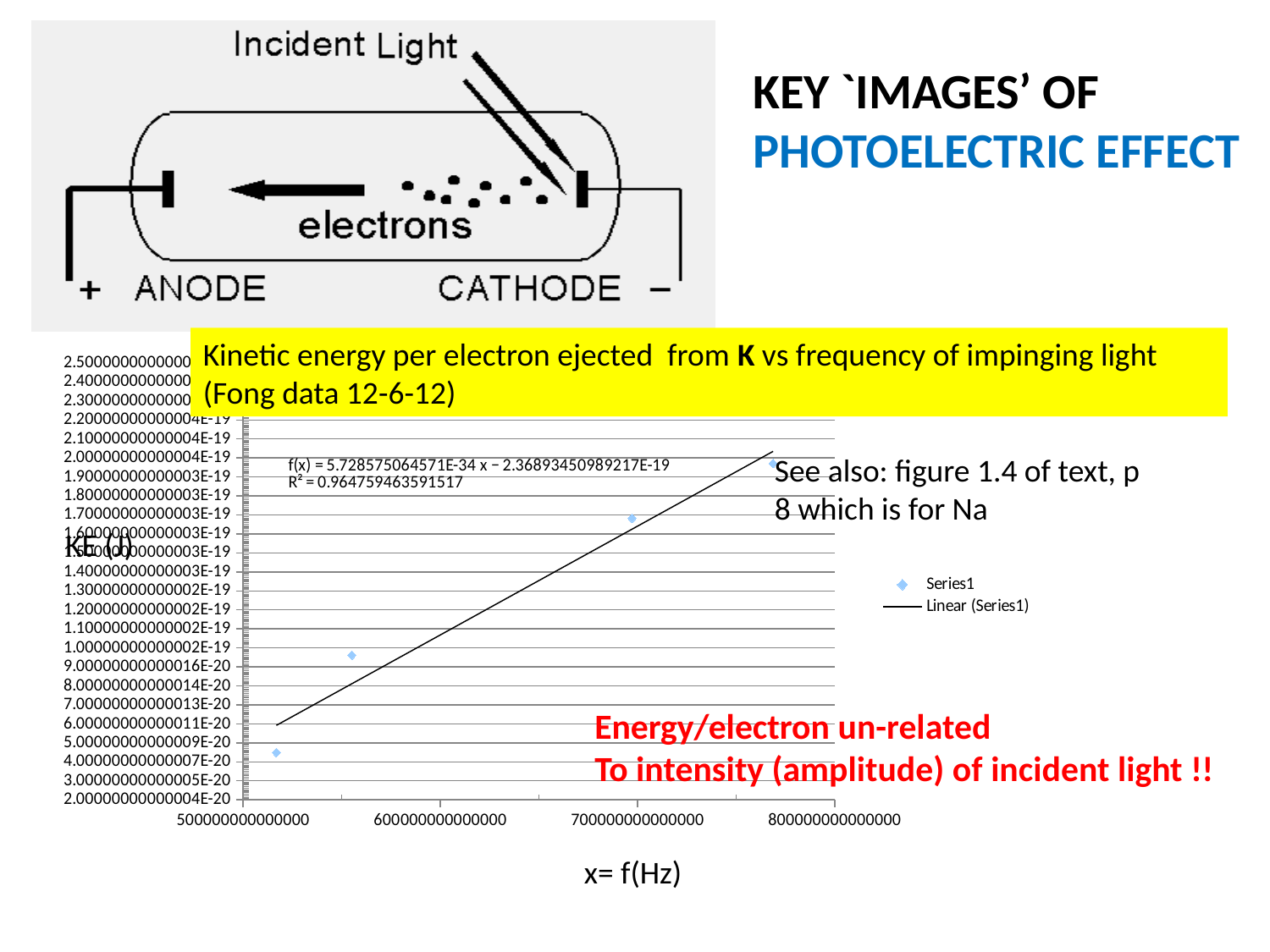
What is the slope of the linear trendline equation printed on the chart? 5.728575064571E-34 What kind of chart is shown on the slide? scatter chart What R² value is printed for the linear trendline on the chart? 0.964759463591517 Is the kinetic energy of the data point just below 600000000000000 Hz greater or less than 1.20000000000002E-19? less Do the plotted kinetic energy values rise or fall as frequency increases along the x axis? rise Is the kinetic energy of the data point at the highest frequency greater or less than 1.80000000000003E-19? greater How many data points are plotted in the chart? 4 Which data point has the highest kinetic energy, the one at the lowest frequency or the one at the highest frequency? the one at the highest frequency Which has the larger kinetic energy: the data point near 700000000000000 Hz or the data point just below 600000000000000 Hz? the point near 700000000000000 Hz How many entries does the chart legend list? 2 Is the kinetic energy of the data point at the lowest frequency greater or less than 1.00000000000002E-19? less